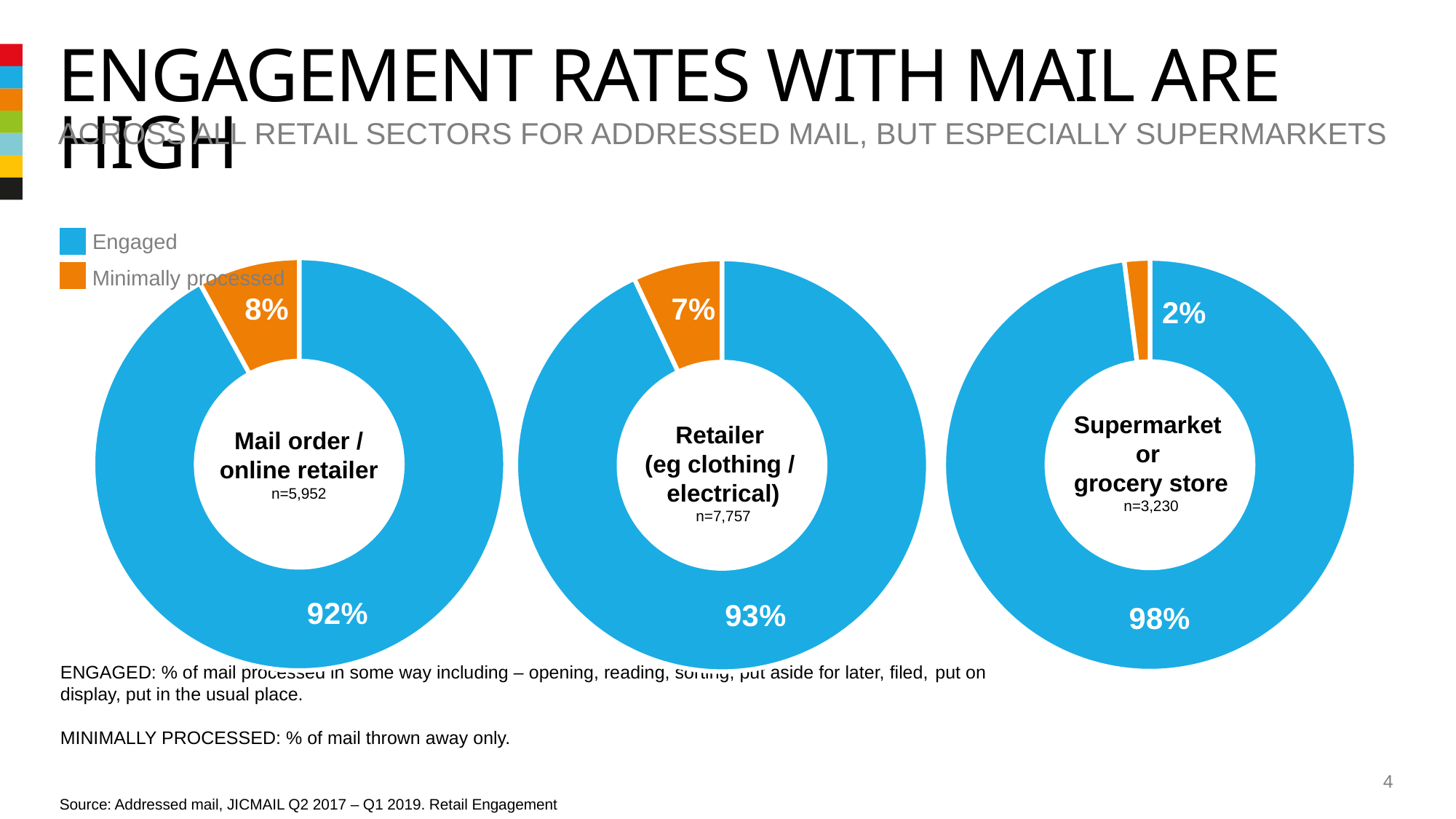
Which of the three charts shows the lowest Engaged percentage? Mail order / online retailer Is the Minimally processed share larger in the Mail order / online retailer chart or the Supermarket or grocery store chart? Mail order / online retailer How many series does the legend list? 2 In the Retailer (eg clothing / electrical) chart, what percentage of mail is Minimally processed? 7% How many doughnut charts are shown on the slide? 3 In the Supermarket or grocery store chart, what percentage of mail is Engaged? 98% What is the sample size (n) shown in the Retailer (eg clothing / electrical) chart? n=7,757 What kind of chart is used to show the engagement rates on this slide? Doughnut (pie) chart In the Mail order / online retailer chart, what percentage of mail is Engaged? 92% Which of the three charts shows the highest Engaged percentage? Supermarket or grocery store What is the difference between the Engaged percentage in the Supermarket or grocery store chart and the Mail order / online retailer chart? 6 percentage points In the Mail order / online retailer chart, what percentage of mail is Minimally processed? 8%